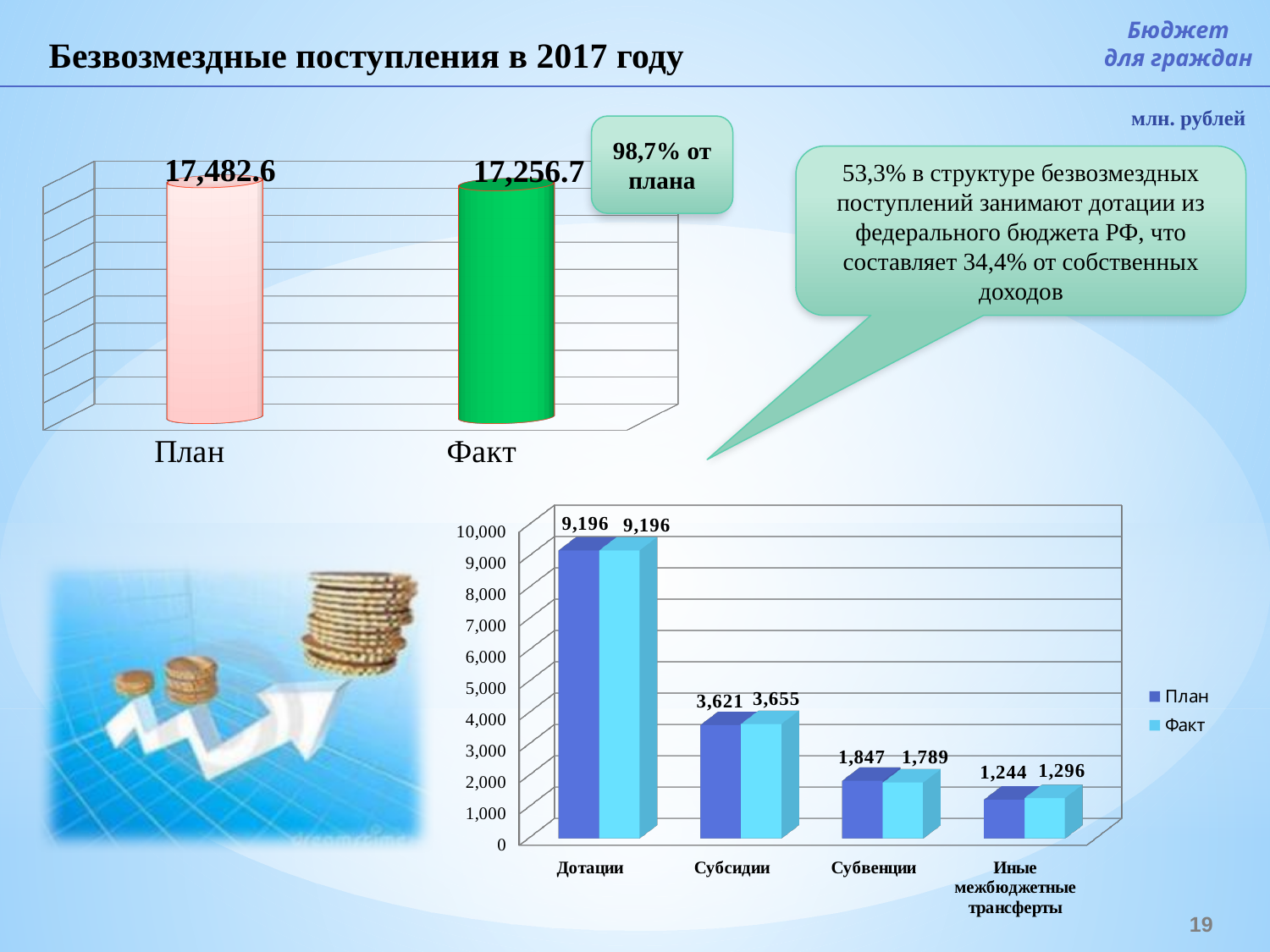
How many categories are shown on the x axis of the bottom chart? 4 In the bottom chart, what is the Факт value for Субвенции? 1,789 In the bottom chart, what is the difference between the Факт and План values for Субсидии? 34 In the top chart, which is larger, План or Факт? План In the top chart, what is the value for План? 17,482.6 In the bottom chart, which category has the lowest values? Иные межбюджетные трансферты In the top chart, what is the value for Факт? 17,256.7 In the top chart, what is the difference between План and Факт? 225.9 In the bottom chart, what is the Факт value for Иные межбюджетные трансферты? 1,296 How many series does the legend of the bottom chart list? 2 In the bottom chart, what is the План value for Субсидии? 3,621 In the bottom chart, which category has the highest values? Дотации